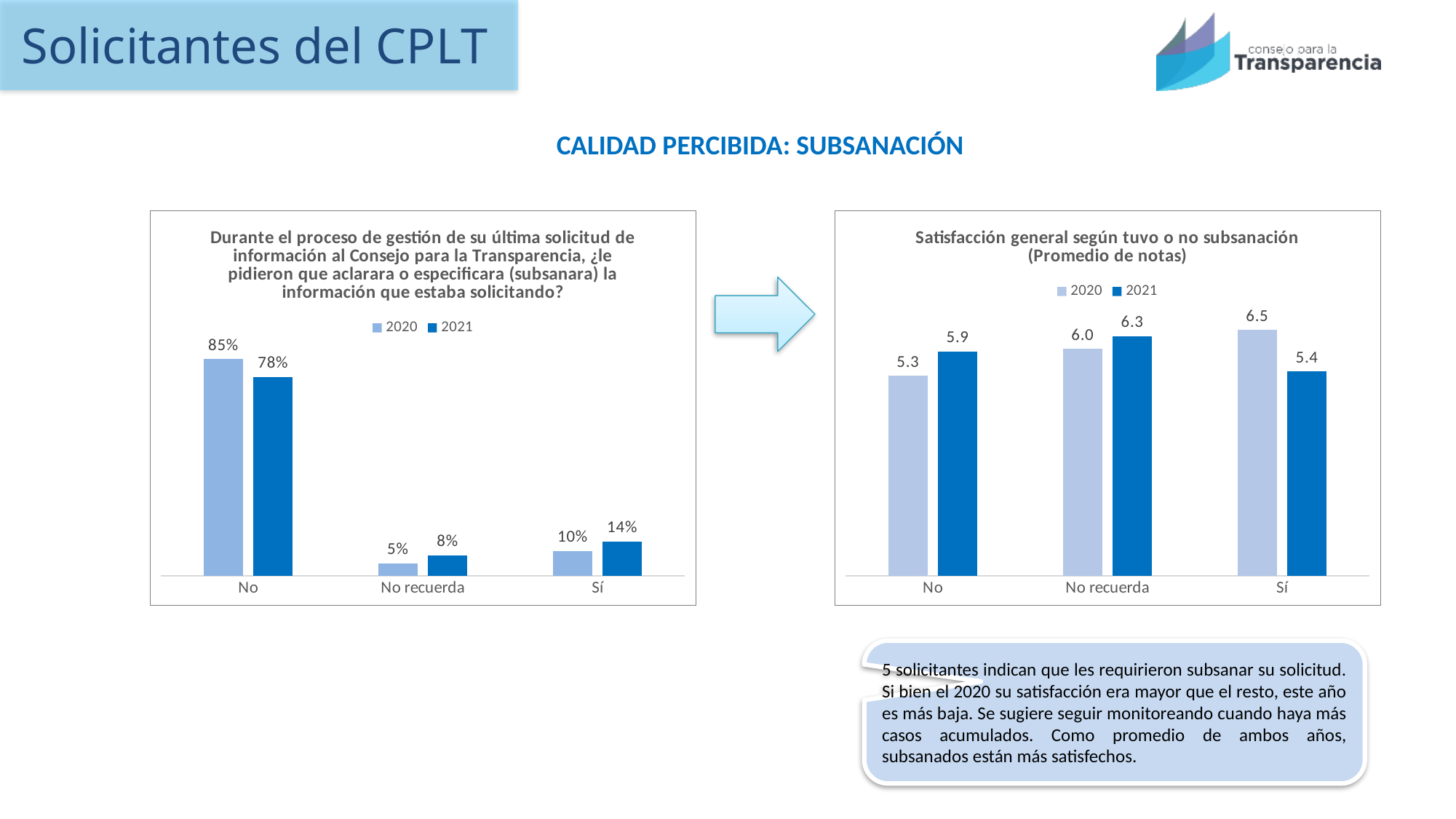
In the left chart, how many categories are shown on the x axis? 3 In the left chart, what is the difference between the 2020 and 2021 values for "No"? 7% In the right chart, what is the 2021 value for "No recuerda"? 6.3 In the left chart, how many series does the legend list? 2 In the right chart, which category has the highest 2020 value? Sí What type of chart is the right chart, titled "Satisfacción general según tuvo o no subsanación"? Bar chart In the right chart, what is the difference between the 2020 and 2021 values for "Sí"? 1.1 In the right chart, what is the 2020 value for "Sí"? 6.5 In the right chart, which is larger for "Sí": the 2020 value or the 2021 value? 2020 In the left chart, which category has the lowest 2020 value? No recuerda In the left chart, what is the 2020 value for "No"? 85% In the left chart, what is the 2021 value for "Sí"? 14%